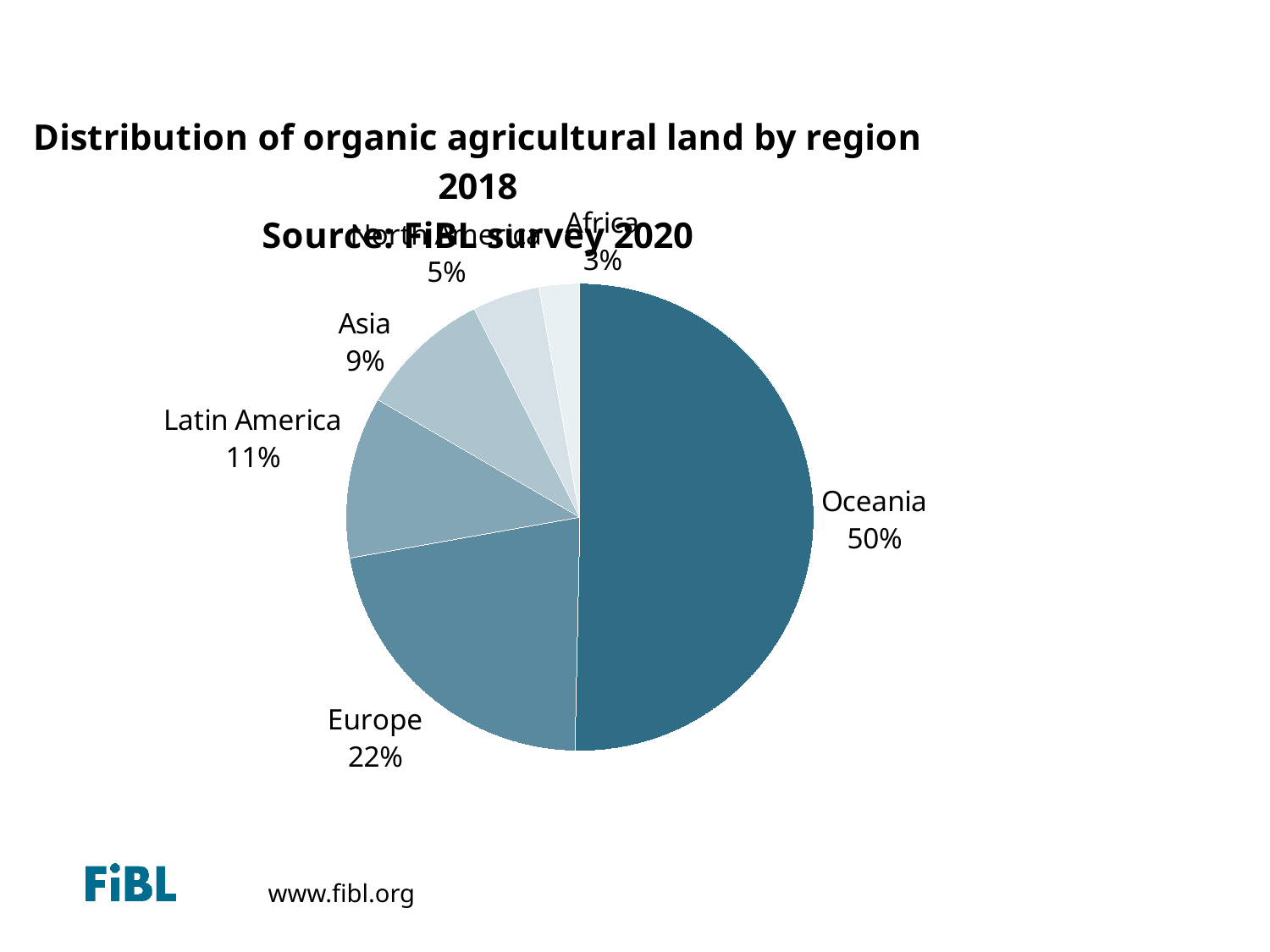
What share of organic agricultural land does Africa hold? 3% Which region has the largest share of organic agricultural land? Oceania What is the difference in percentage points between Latin America and Asia? 2 Which has a larger share, Europe or Latin America? Europe What type of chart is shown on the slide? Pie chart What percentage is shown for Asia? 9% What percentage of organic agricultural land is in Europe? 22% How many regions are shown in the pie chart? 6 What is the share for Latin America? 11% How many percentage points larger is Oceania's share than Europe's? 28 Which region has the smallest share of organic agricultural land? Africa What share of organic agricultural land does Oceania hold? 50%